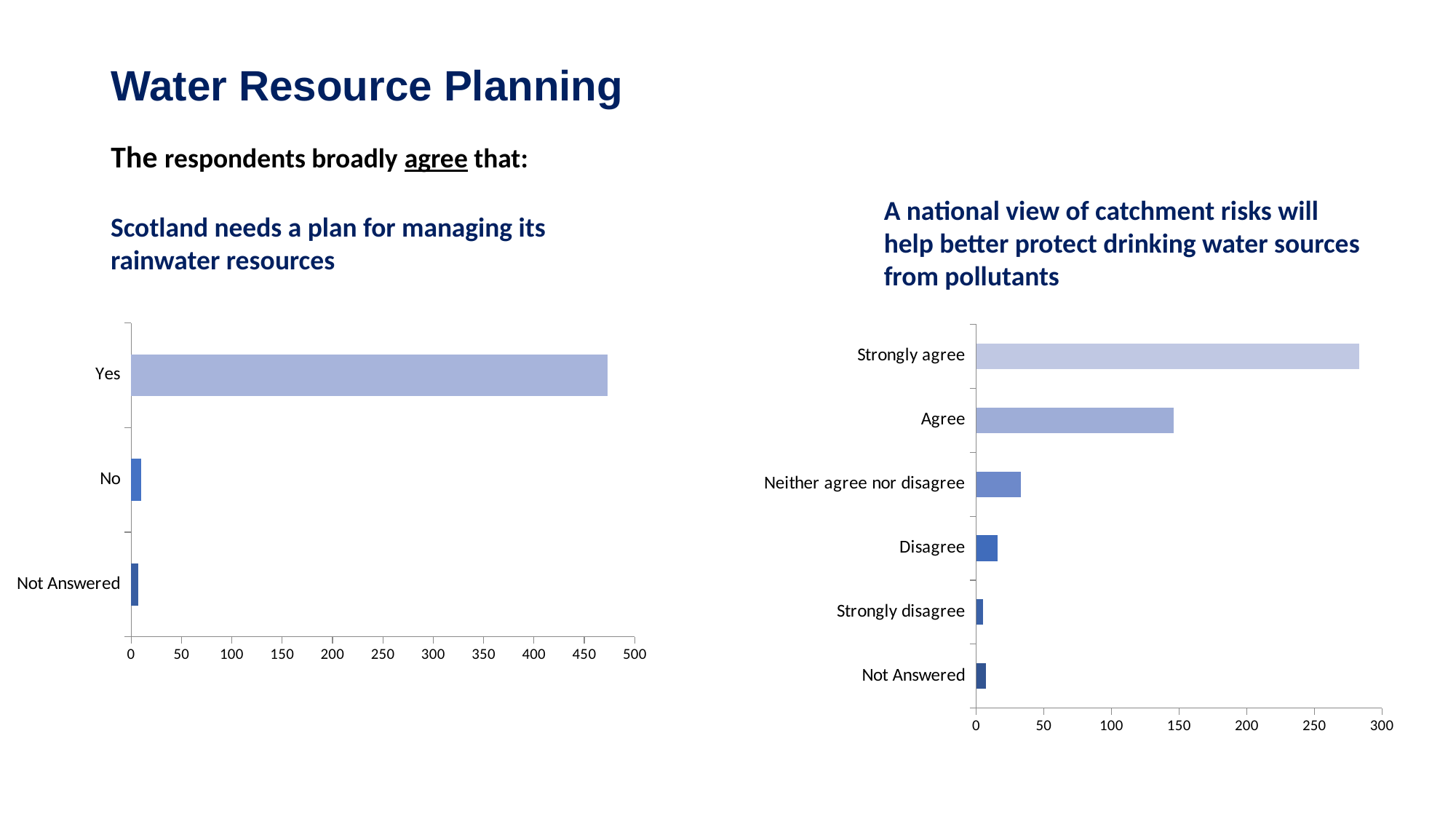
On the right chart, 'A national view of catchment risks will help better protect drinking water sources from pollutants', which category has the highest value? Strongly agree On the left chart, 'Scotland needs a plan for managing its rainwater resources', is the value for No greater or less than 50? less What is the maximum value shown on the x axis of the right chart, 'A national view of catchment risks will help better protect drinking water sources from pollutants'? 300 On the right chart, 'A national view of catchment risks will help better protect drinking water sources from pollutants', is the value for Neither agree nor disagree greater or less than 50? less On the left chart, 'Scotland needs a plan for managing its rainwater resources', which category has the highest value? Yes How many categories are shown on the left chart, 'Scotland needs a plan for managing its rainwater resources'? 3 What kind of chart is the left chart, 'Scotland needs a plan for managing its rainwater resources'? bar chart On the left chart, 'Scotland needs a plan for managing its rainwater resources', which is larger, the value for Yes or the value for No? Yes On the right chart, 'A national view of catchment risks will help better protect drinking water sources from pollutants', is the value for Strongly agree greater or less than 250? greater How many categories are shown on the right chart, 'A national view of catchment risks will help better protect drinking water sources from pollutants'? 6 On the right chart, 'A national view of catchment risks will help better protect drinking water sources from pollutants', which is larger, the value for Agree or the value for Disagree? Agree